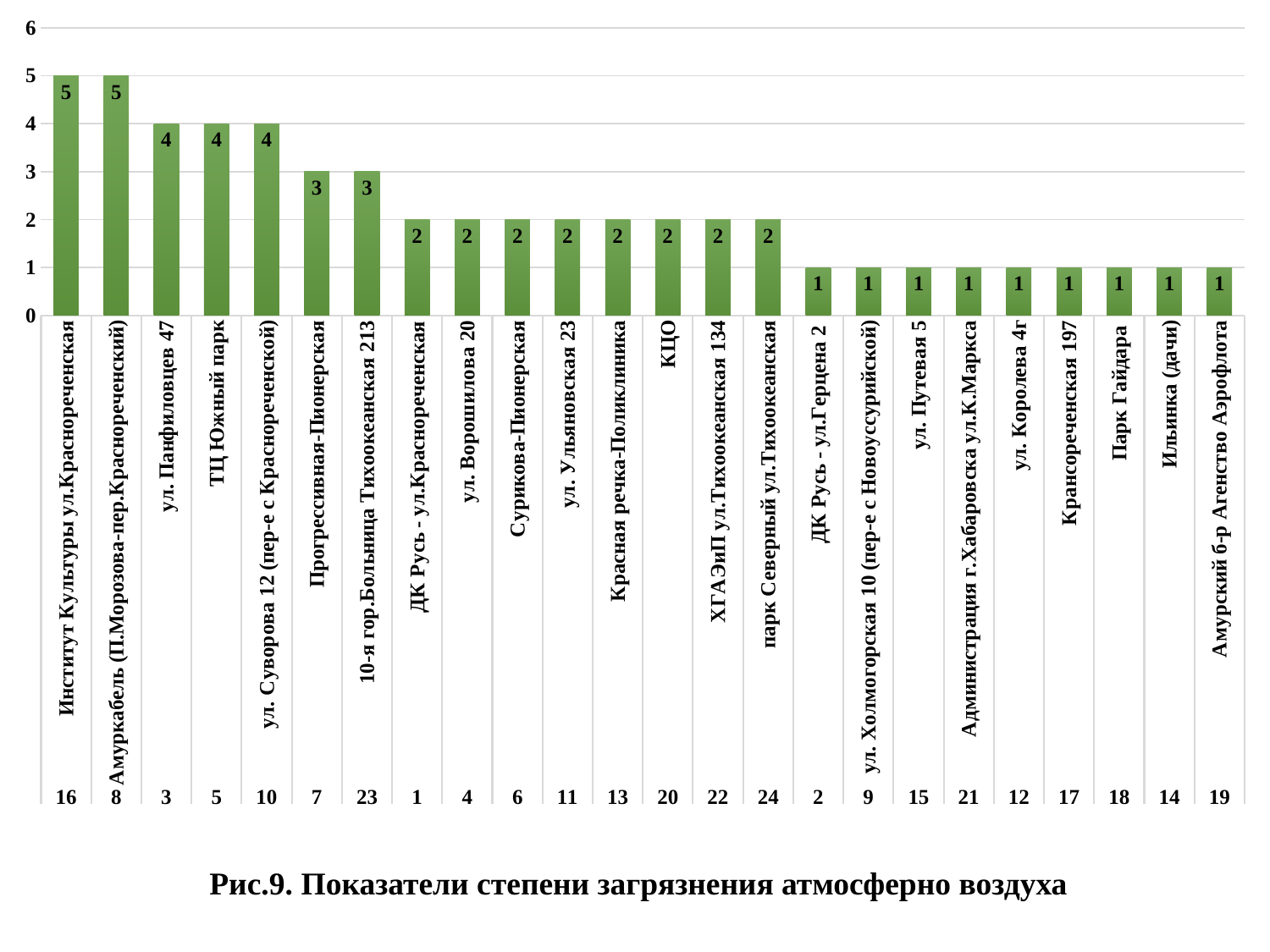
What is the value for ул. Панфиловцев 47? 4 What is the value for Прогрессивная-Пионерская? 3 What is the value for Парк Гайдара? 1 Do the values rise or fall from left to right along the x axis? fall What is the value for Амуркабель (П.Морозова-пер.Краснореченский)? 5 Which has a larger value, ТЦ Южный парк or 10-я гор.Больница Тихоокеанская 213? ТЦ Южный парк What is the lowest value shown on the chart? 1 What kind of chart is shown on the slide? bar chart What is the value for КЦО? 2 What is the difference between the values for Институт Культуры ул.Краснореченская and ул. Путевая 5? 4 How many categories (bars) are shown on the chart? 24 What is the highest value shown on the chart? 5